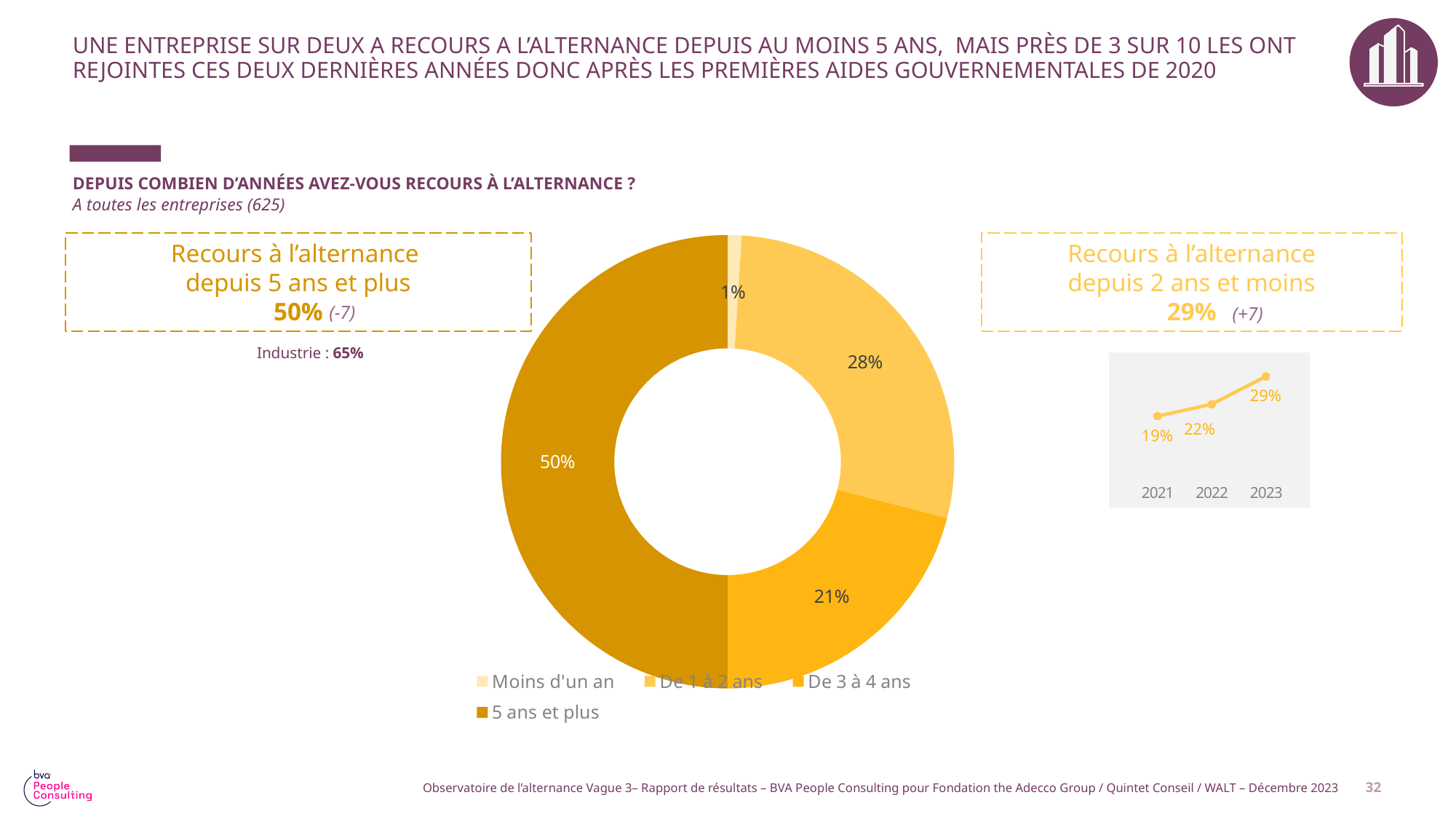
In the small line chart on the right, what is the value for 2021? 19% What type of chart is the large chart in the centre of the slide? Donut (pie) chart In the donut chart, which category has the smallest share? Moins d'un an In the donut chart, what is the value for De 3 à 4 ans? 21% In the donut chart, what is the difference between the shares for De 1 à 2 ans and De 3 à 4 ans? 7 percentage points In the donut chart, what share of companies have used alternance for 5 ans et plus? 50% How many categories does the legend of the donut chart list? 4 In the donut chart, which is larger: De 1 à 2 ans or De 3 à 4 ans? De 1 à 2 ans In the donut chart, what is the value for Moins d'un an? 1% In the donut chart, which category has the largest share? 5 ans et plus In the small line chart on the right, do the values rise or fall from 2021 to 2023? Rise In the donut chart, what is the value for De 1 à 2 ans? 28%